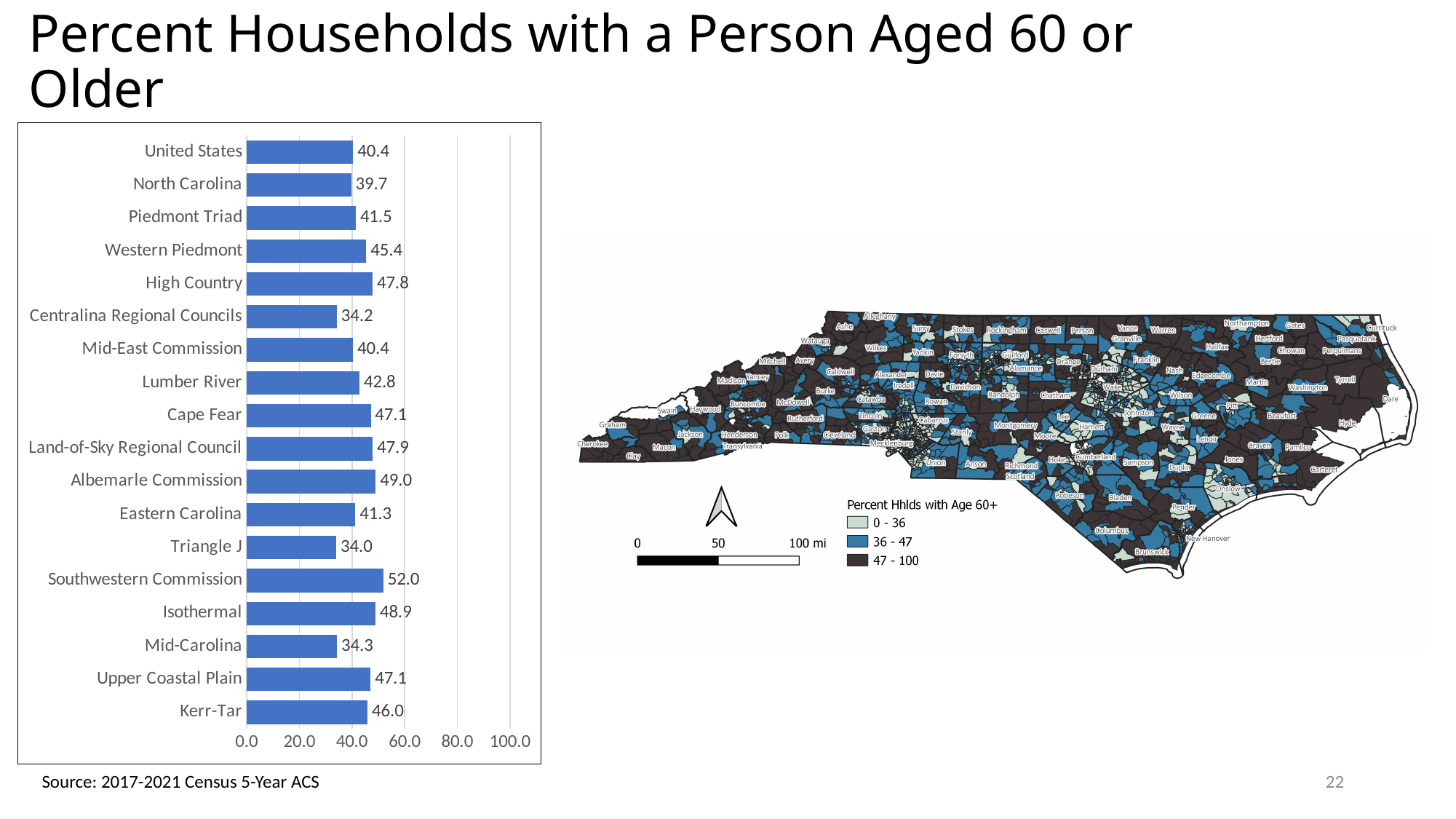
In the bar chart, what is the difference between the values for Albemarle Commission and Isothermal? 0.1 In the bar chart, is the value for Centralina Regional Councils greater or less than 40.0? less In the bar chart, which is larger, the value for Kerr-Tar or the value for Western Piedmont? Kerr-Tar In the bar chart, which category has the lowest value? Triangle J How many value ranges does the map legend 'Percent Hhlds with Age 60+' list? 3 In the bar chart, what is the difference between the values for Southwestern Commission and Triangle J? 18.0 In the bar chart, what is the value for North Carolina? 39.7 How many categories are shown in the bar chart? 18 What kind of chart is shown on the left of the slide? bar chart In the bar chart, what is the value for Southwestern Commission? 52.0 In the bar chart, what is the value for Land-of-Sky Regional Council? 47.9 In the bar chart, which category has the highest value? Southwestern Commission